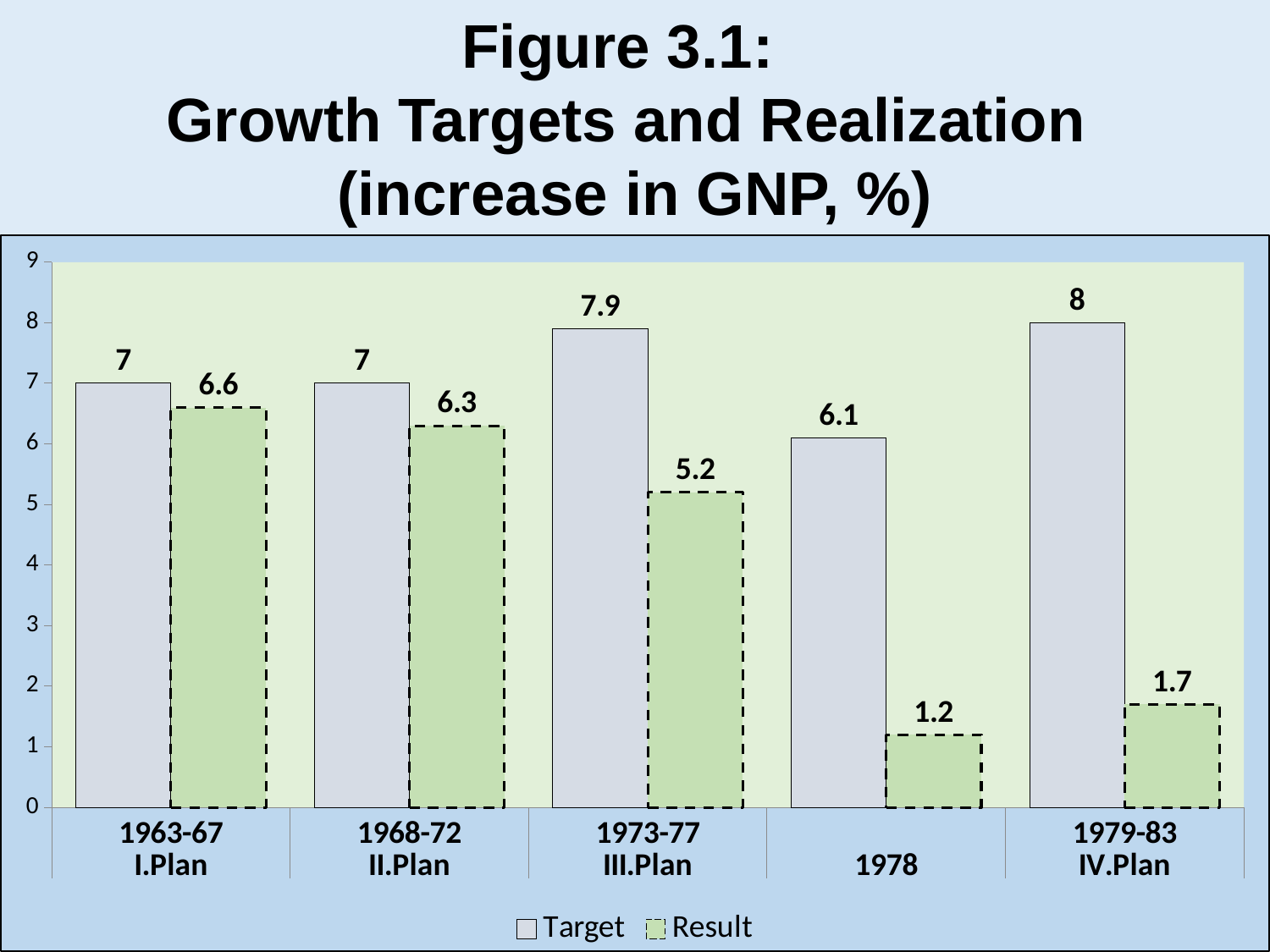
What is the difference between the Target and Result values for 1979-83 IV.Plan? 6.3 Which is larger, the Result for 1968-72 II.Plan or the Result for 1973-77 III.Plan? 1968-72 II.Plan Which period has the highest Target value? 1979-83 IV.Plan What is the Result value for 1963-67 I.Plan? 6.6 What are the two series named in the legend? Target and Result Which period has the lowest Result value? 1978 Is the Target value for 1978 greater or less than 7? less How many periods are shown on the x axis? 5 What kind of chart is shown on the slide? bar chart What is the Result value for 1978? 1.2 What is the Target value for 1973-77 III.Plan? 7.9 How many series does the legend list? 2